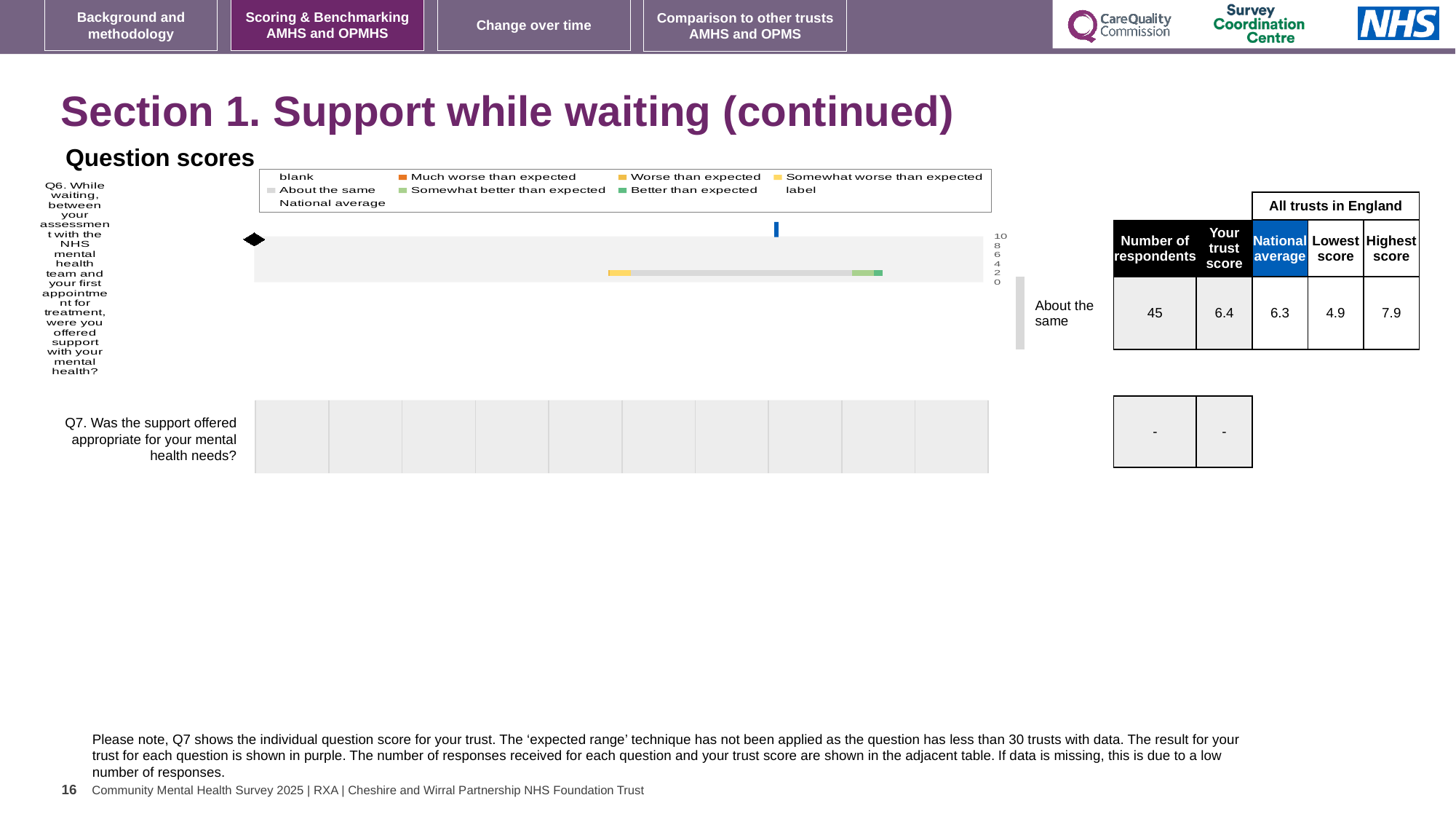
What is the highest score among all trusts in England for Q6? 7.9 What is the trust score for Q6 shown next to the chart? 6.4 What is the difference between the highest and lowest scores for Q6 among all trusts in England? 3.0 What is the lowest score among all trusts in England for Q6? 4.9 What is the national average for Q6 shown next to the chart? 6.3 What is the number of respondents for Q6 in the table next to the chart? 45 For Q6, which is larger: the trust score or the national average? the trust score How many entries does the legend of the question scores chart list? 9 What kind of chart is used to show the question scores on this slide? bar chart Which legend entry in the question scores chart is shown in orange? Much worse than expected What category label is given to the Q6 bar in the question scores chart? About the same